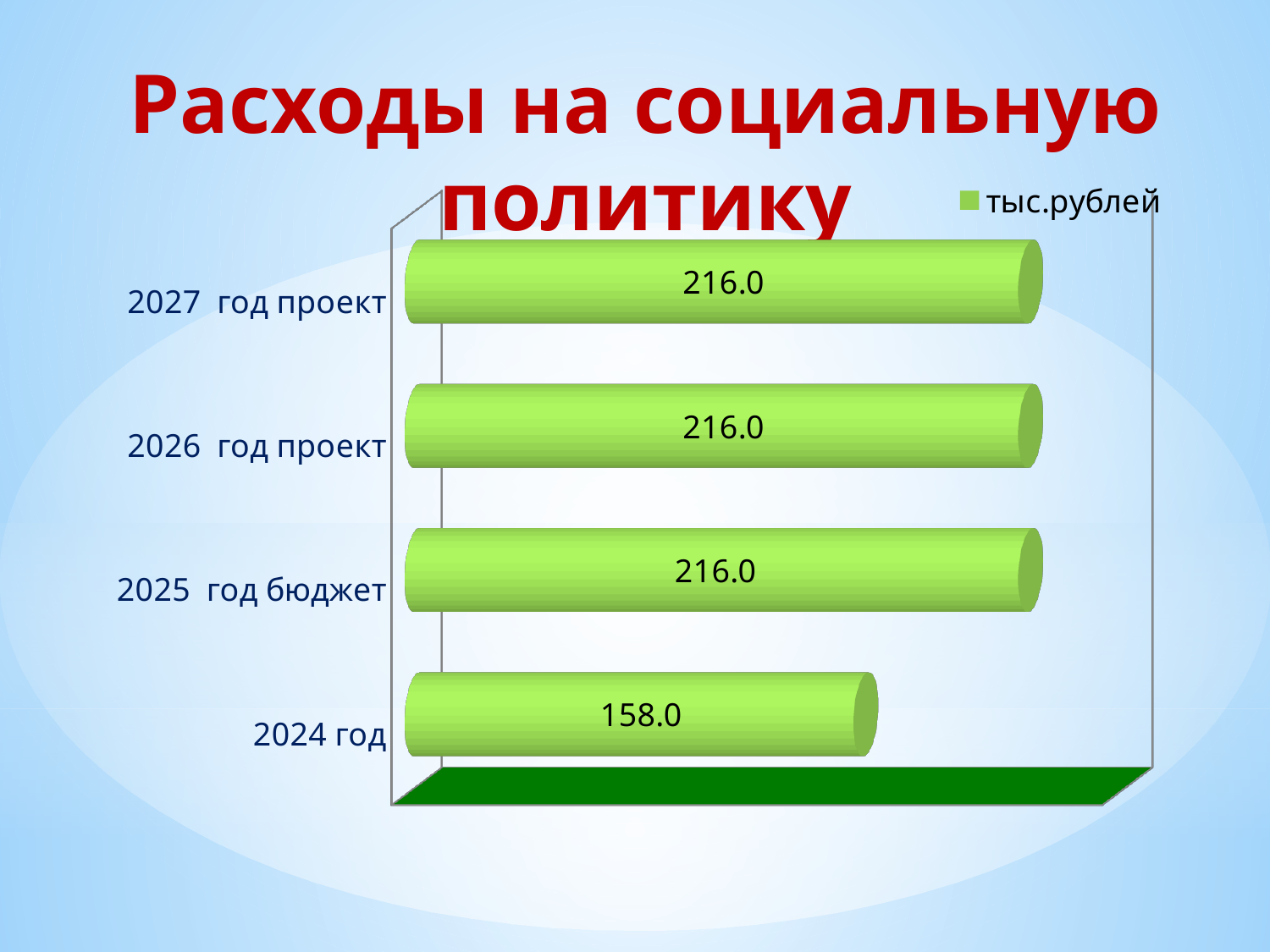
What kind of chart is shown on the slide? bar chart Do the values for 2026 год проект and 2027 год проект differ? No What is the legend entry shown in the chart? тыс.рублей Which category has the lowest value? 2024 год Which is larger, the value for 2026 год проект or the value for 2024 год? 2026 год проект What is the value for 2024 год? 158.0 What is the title of the chart? Расходы на социальную политику What is the value for 2027 год проект? 216.0 What is the value for 2025 год бюджет? 216.0 How many series does the legend list? 1 What is the difference between the values for 2025 год бюджет and 2024 год? 58.0 How many categories are shown in the chart? 4